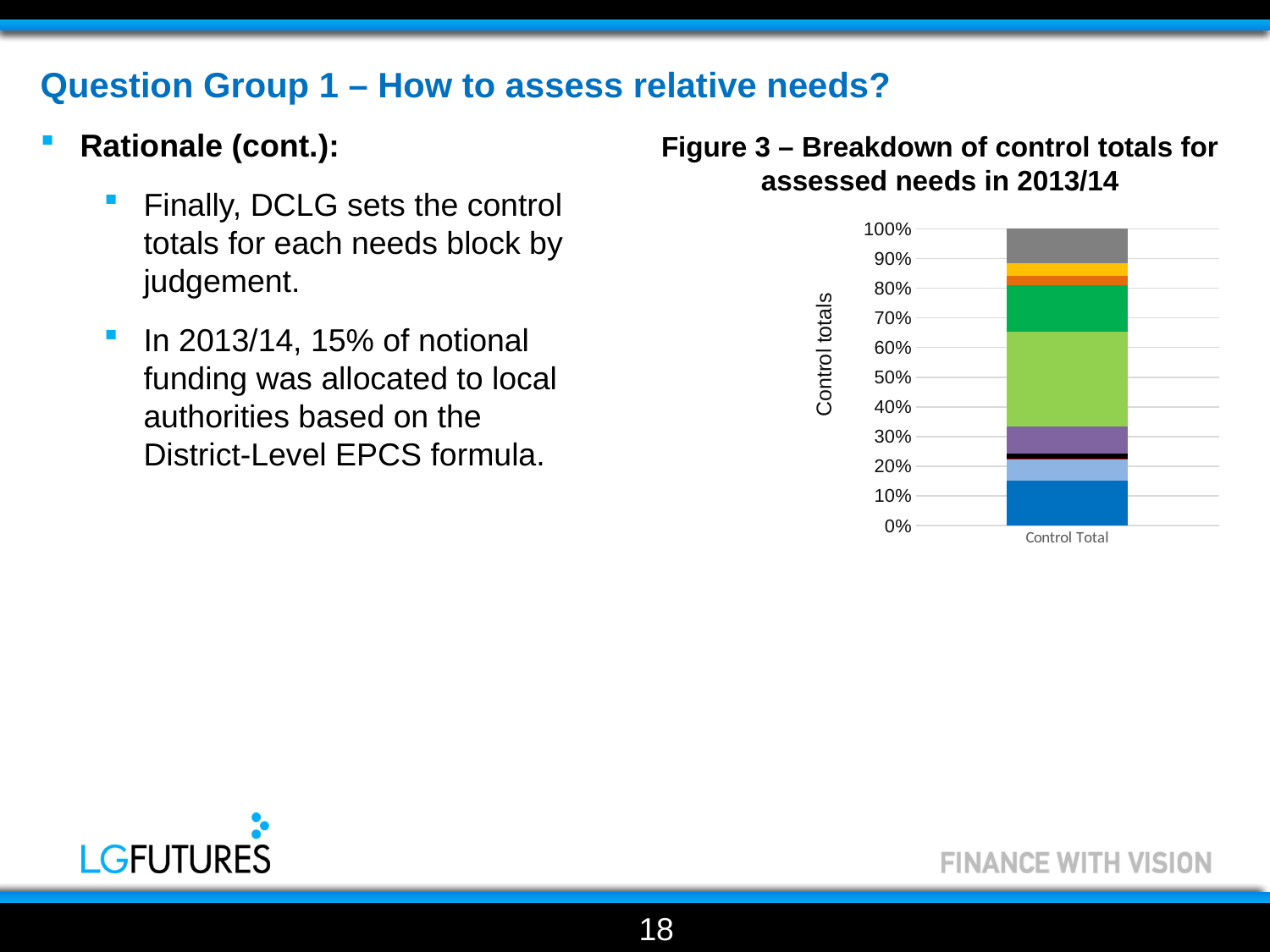
What is the total height of the stacked bar for Control Total? 100% What is the highest value shown on the vertical axis of the chart? 100% What is the label on the vertical axis of the chart? Control totals What is the title of the chart on the slide? Figure 3 – Breakdown of control totals for assessed needs in 2013/14 What is the label of the single category on the x axis of the chart? Control Total How many categories are plotted on the x axis of the chart? 1 What is the lowest value shown on the vertical axis of the chart? 0% What kind of chart is shown in Figure 3? Stacked bar chart